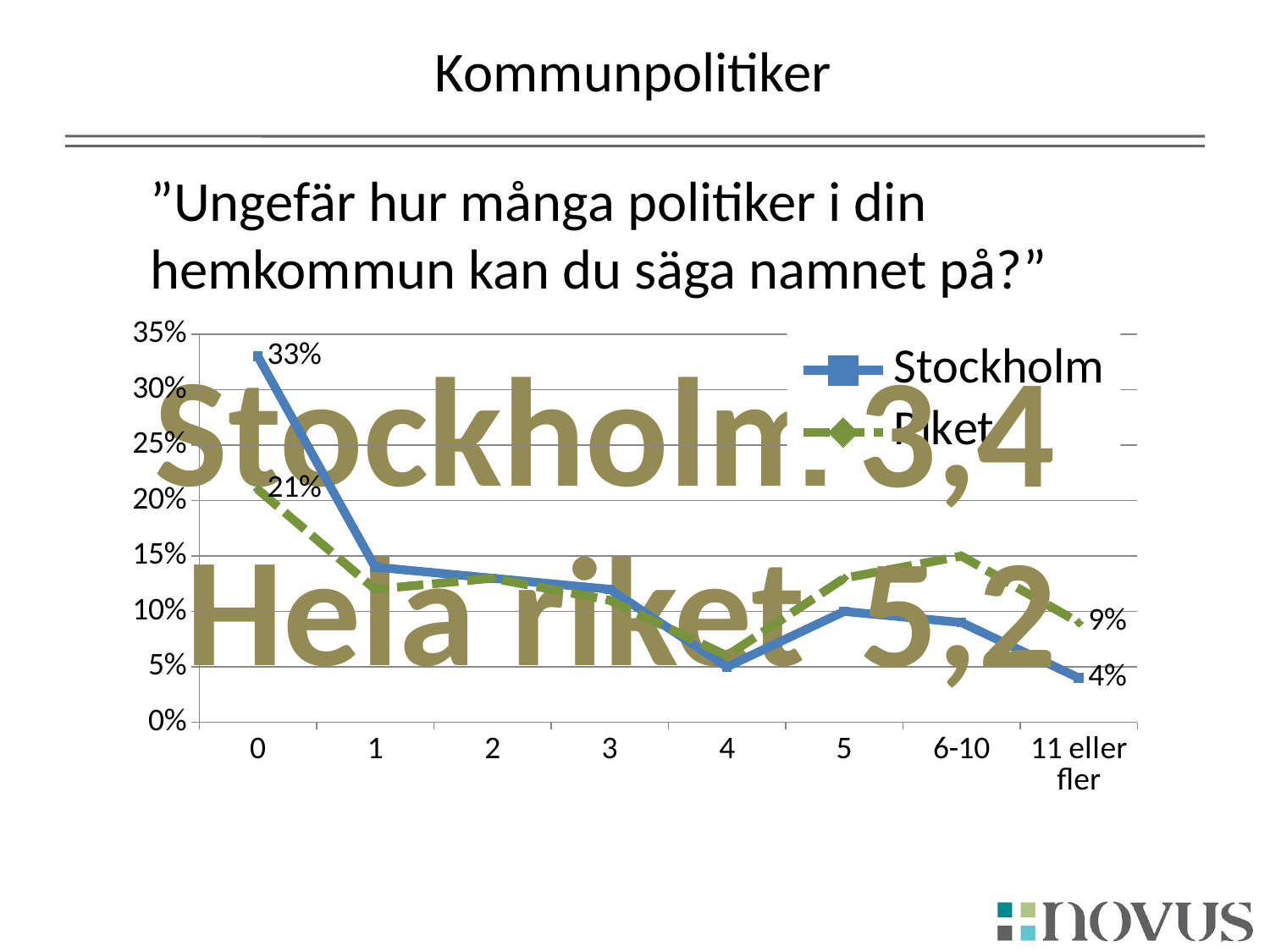
How many series does the legend list? 2 What is the value for Riket at category 0? 21% How many categories are shown on the x axis? 8 What is the difference between the Stockholm and Riket values at category 0? 12 percentage points At category "11 eller fler", which series has the larger value, Stockholm or Riket? Riket Is the value for Stockholm at category 4 greater or less than 10%? less What is the value for Stockholm at category "11 eller fler"? 4% What is the value for Stockholm at category 0? 33% What kind of chart is shown on the slide? Line chart Is the value for Riket at category 6-10 greater or less than 10%? greater At category 0, which series has the larger value, Stockholm or Riket? Stockholm What is the value for Riket at category "11 eller fler"? 9%